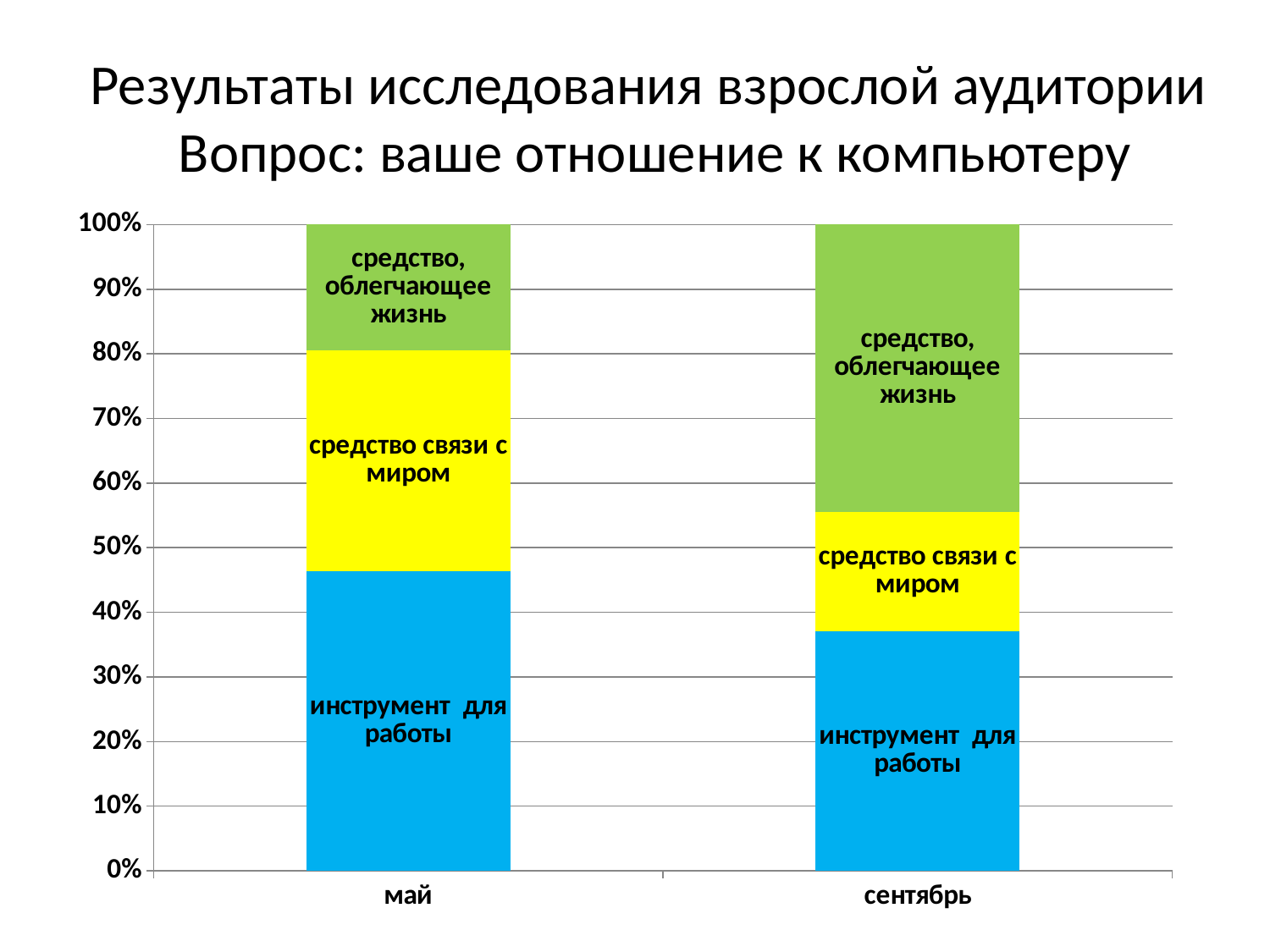
Is the share of 'средство, облегчающее жизнь' in сентябрь greater or less than 40%? greater Is the share of 'инструмент для работы' in сентябрь greater or less than 40%? less Does the share of 'инструмент для работы' rise or fall from май to сентябрь? fall Which segment is the smallest in the сентябрь bar? средство связи с миром Is the share of 'средство, облегчающее жизнь' in май greater or less than 30%? less What kind of chart is shown on the slide? Stacked bar chart How many categories are shown on the x axis of the chart? 2 How many segments (series) does each stacked bar contain? 3 What colour is the 'средство связи с миром' segment in the chart? Yellow Which segment is the largest in the сентябрь bar? средство, облегчающее жизнь In which month is the share of 'средство связи с миром' larger, май or сентябрь? май